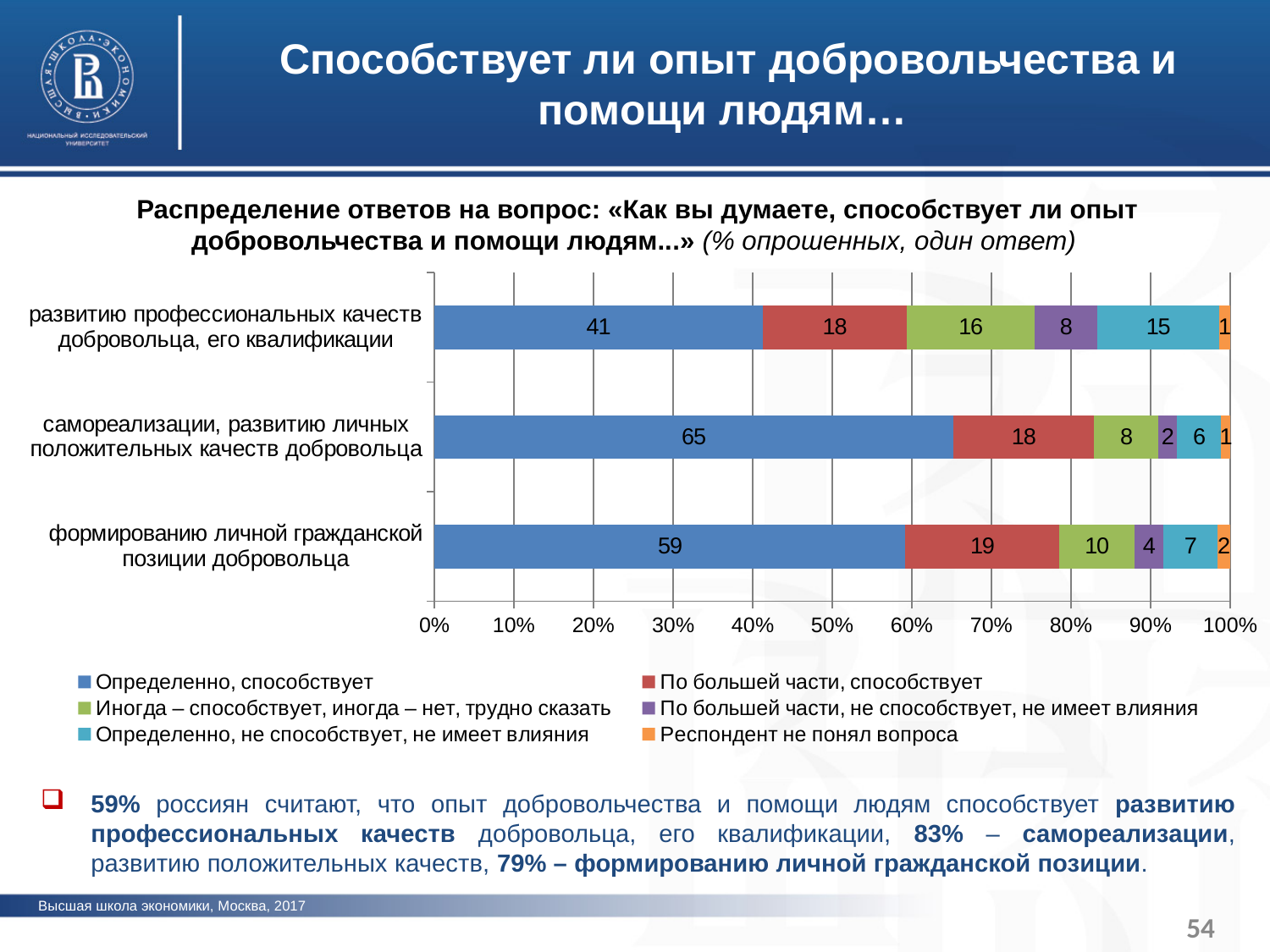
What is the value of «По большей части, способствует» for «формированию личной гражданской позиции добровольца»? 19 What is the difference between the «Определенно, способствует» values for «самореализации, развитию личных положительных качеств добровольца» and «развитию профессиональных качеств добровольца, его квалификации»? 24 Which is larger: the «Иногда – способствует, иногда – нет, трудно сказать» value for «развитию профессиональных качеств добровольца, его квалификации» or for «формированию личной гражданской позиции добровольца»? развитию профессиональных качеств добровольца, его квалификации Which category has the highest value for «Определенно, способствует»? самореализации, развитию личных положительных качеств добровольца What is the value of «Определенно, не способствует, не имеет влияния» for «развитию профессиональных качеств добровольца, его квалификации»? 15 What is the value of «Определенно, способствует» for «развитию профессиональных качеств добровольца, его квалификации»? 41 Which category has the lowest value for «Определенно, способствует»? развитию профессиональных качеств добровольца, его квалификации What is the value of «Определенно, способствует» for «самореализации, развитию личных положительных качеств добровольца»? 65 How many categories (rows) does the chart show? 3 How many series does the legend list? 6 What type of chart is shown on the slide? stacked bar chart Which colour represents «Респондент не понял вопроса» in the legend? orange